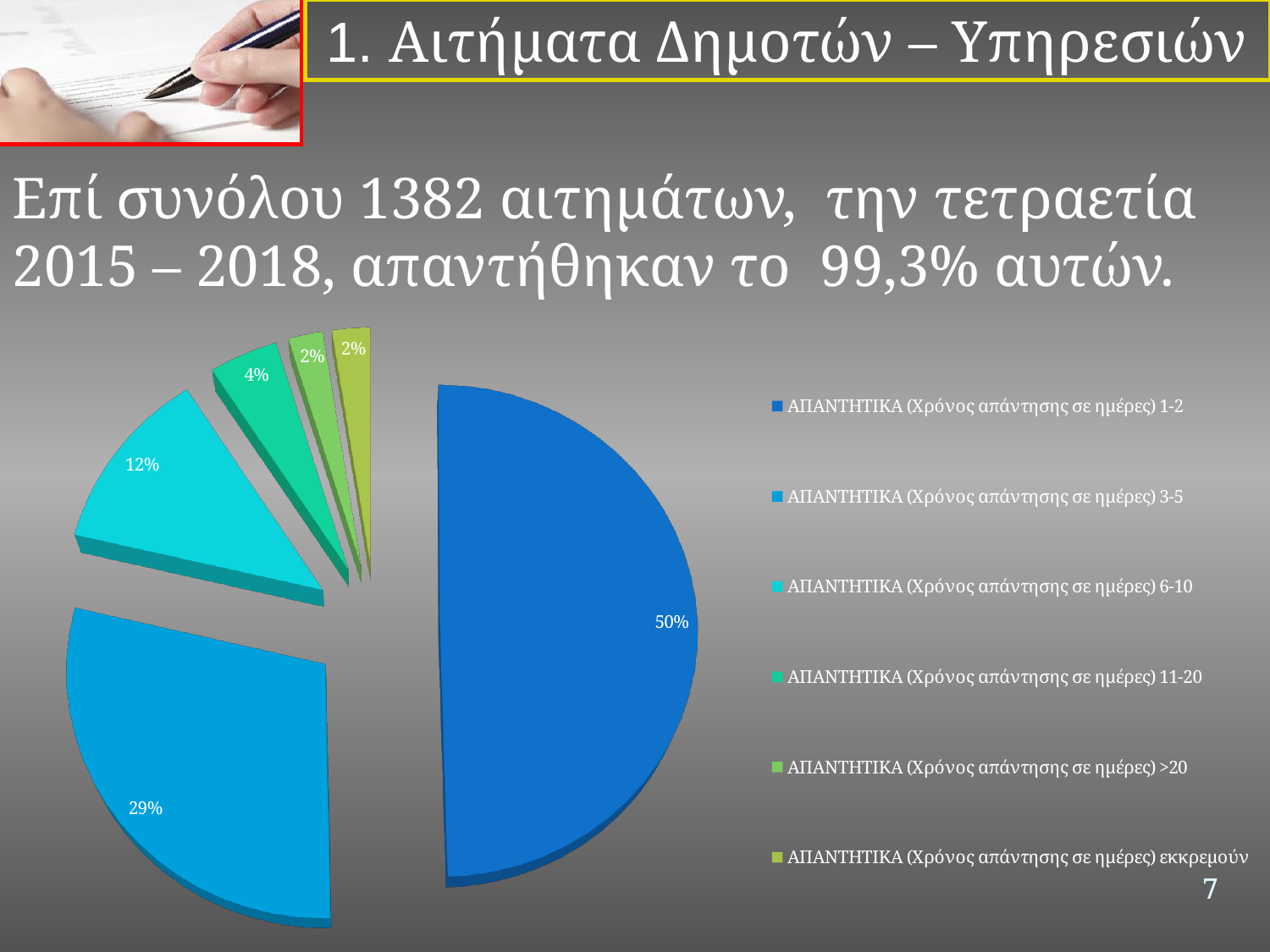
What percentage is shown for requests answered in 3-5 days (ΑΠΑΝΤΗΤΙΚΑ 3-5)? 29% What is the combined percentage of the 1-2 days and 3-5 days slices? 79% What percentage is shown for requests answered in 6-10 days (ΑΠΑΝΤΗΤΙΚΑ 6-10)? 12% What type of chart is shown on the slide? pie chart What is the legend label of the last entry in the legend? ΑΠΑΝΤΗΤΙΚΑ (Χρόνος απάντησης σε ημέρες) εκκρεμούν How many entries does the legend list? 6 Which response-time category has the largest slice of the pie? ΑΠΑΝΤΗΤΙΚΑ (Χρόνος απάντησης σε ημέρες) 1-2 What share of the pie corresponds to requests answered in 1-2 days (ΑΠΑΝΤΗΤΙΚΑ 1-2)? 50% How many slices does the pie chart have? 6 What is the difference in percentage points between the 1-2 days slice and the 3-5 days slice? 21 What percentage is shown for requests answered in 11-20 days (ΑΠΑΝΤΗΤΙΚΑ 11-20)? 4% Which slice is larger: 6-10 days or 11-20 days? 6-10 days